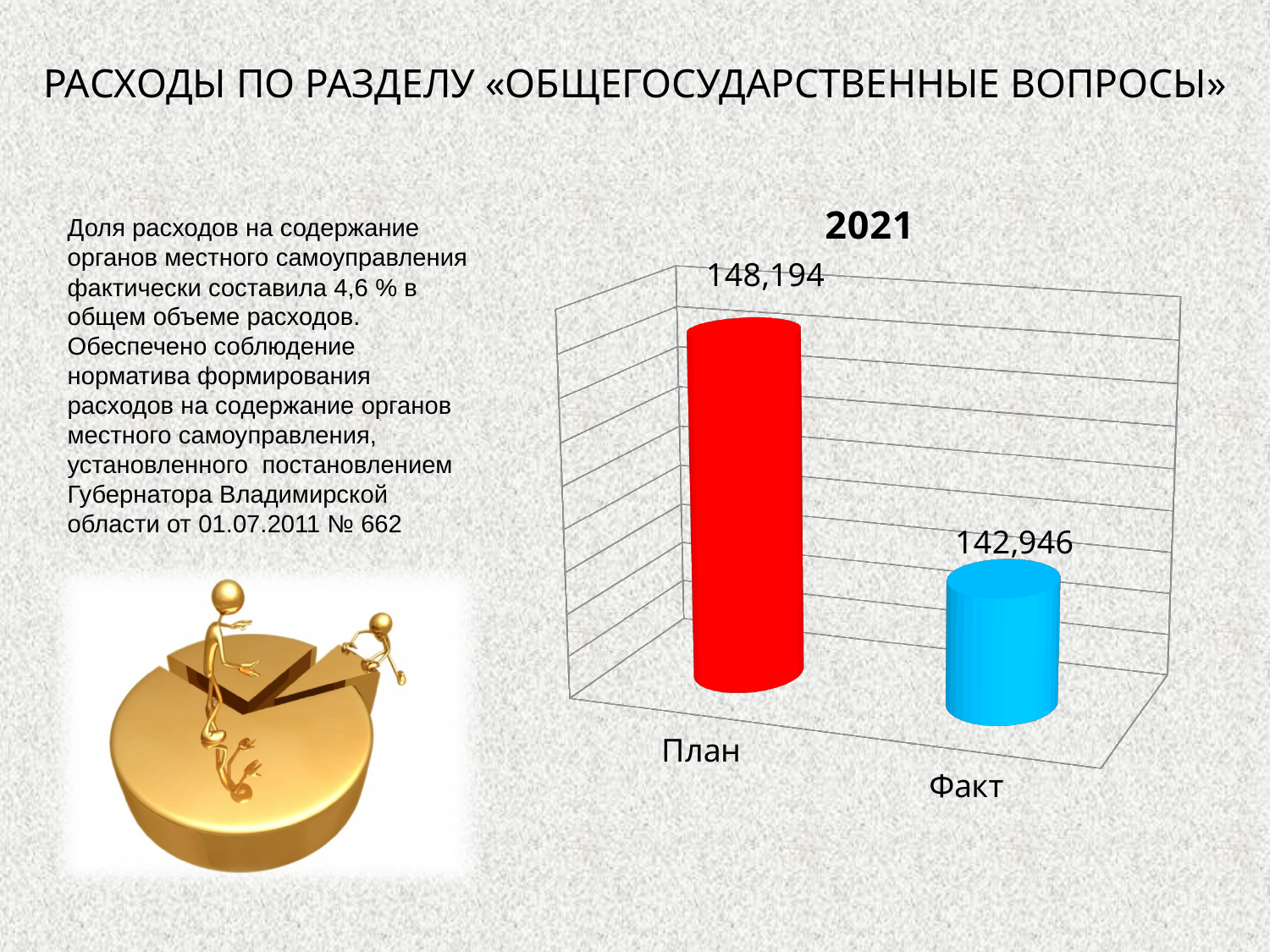
What kind of chart is shown on the slide? Bar chart What is the difference between the План and Факт values? 5,248 How many categories are shown in the chart? 2 What colour is the bar for Факт? Blue Which category has the highest value in the chart? План Which category has the higher value, План or Факт? План What is the value for План in the 2021 chart? 148,194 What is the title of the chart? 2021 What is the value for Факт in the 2021 chart? 142,946 Which category has the lowest value in the chart? Факт Do the values rise or fall from План to Факт? Fall